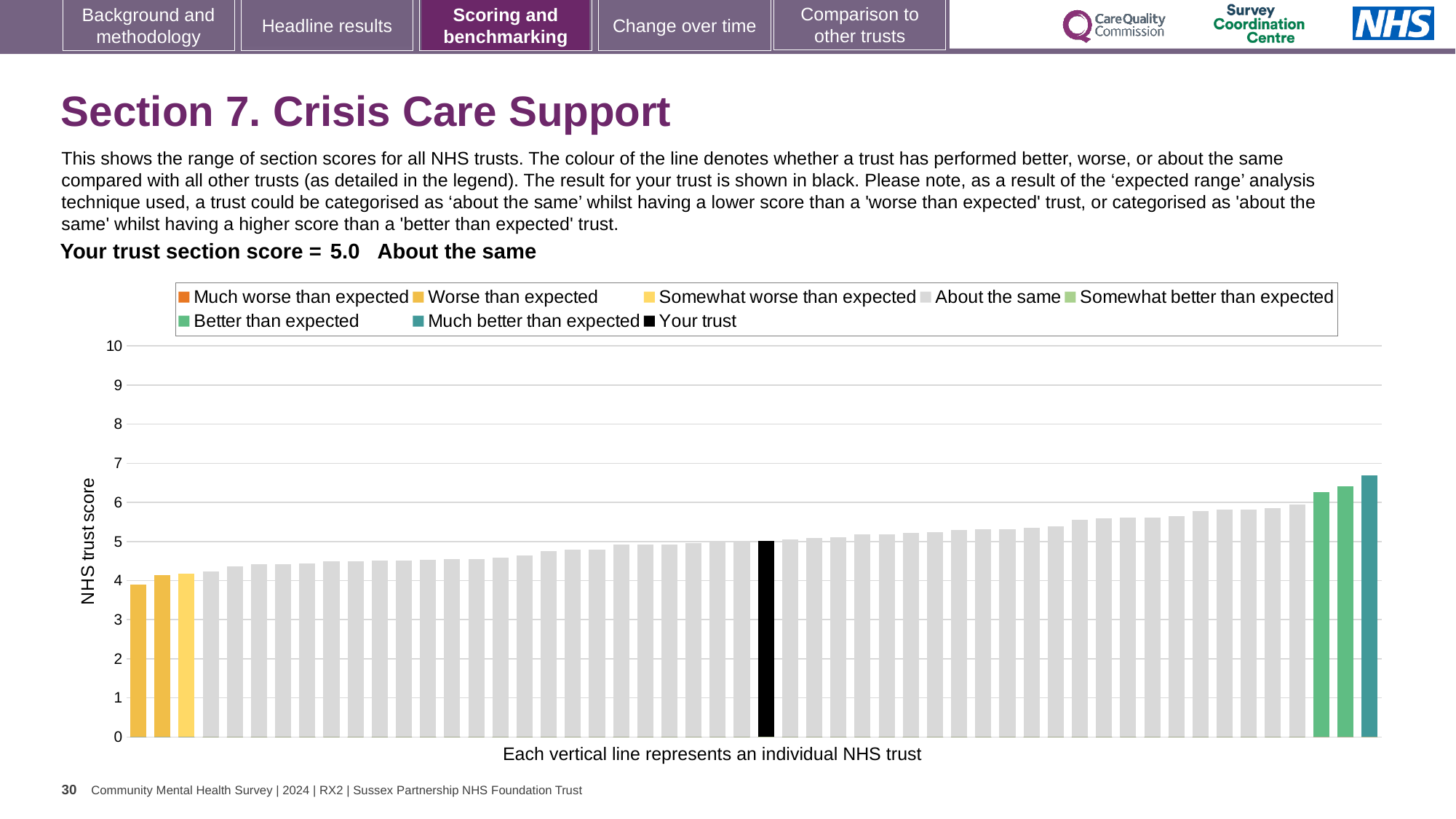
Is the value of the highest bar greater or less than 6? greater Do the bar values rise or fall from left to right along the x axis? rise Is the value for your trust greater or less than 6? less What colour is the bar representing your trust? black Which is larger: the value for your trust or the value of the rightmost bar? the rightmost bar Is the value of the lowest bar greater or less than 5? less What is the section score for your trust shown on the slide? 5.0 What is the label on the vertical axis of the chart? NHS trust score What kind of chart is shown on the slide? bar chart How many entries does the chart legend list? 8 How many bars are coloured as 'Much better than expected'? 1 How is your trust's section score categorised compared with other trusts? About the same